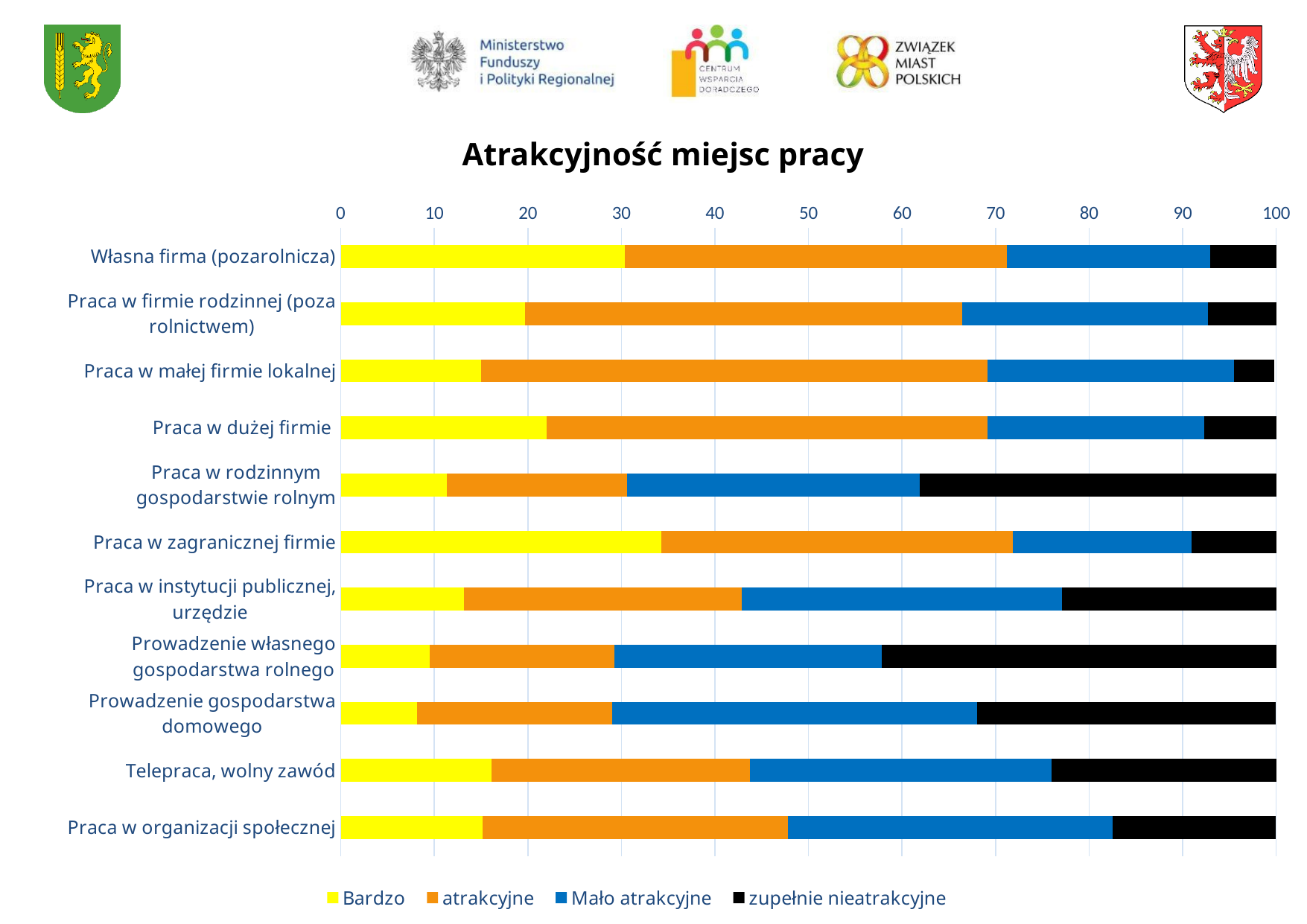
Which category has the largest 'Bardzo' segment? Praca w zagranicznej firmie Which category has the smallest 'zupełnie nieatrakcyjne' segment? Praca w małej firmie lokalnej Which series is shown in black in the legend? zupełnie nieatrakcyjne Which category has the largest 'zupełnie nieatrakcyjne' segment? Prowadzenie własnego gospodarstwa rolnego Is the 'Bardzo' value for Praca w zagranicznej firmie greater or less than 30? greater Is the 'Bardzo' value for Własna firma (pozarolnicza) greater or less than 20? greater How many categories (job types) are listed on the chart? 11 How many series does the legend list? 4 What kind of chart is shown on the slide? Stacked bar chart Which has a larger 'Bardzo' segment: Własna firma (pozarolnicza) or Praca w małej firmie lokalnej? Własna firma (pozarolnicza) What is the title of the chart? Atrakcyjność miejsc pracy Is the 'Bardzo' value for Prowadzenie gospodarstwa domowego greater or less than 10? less